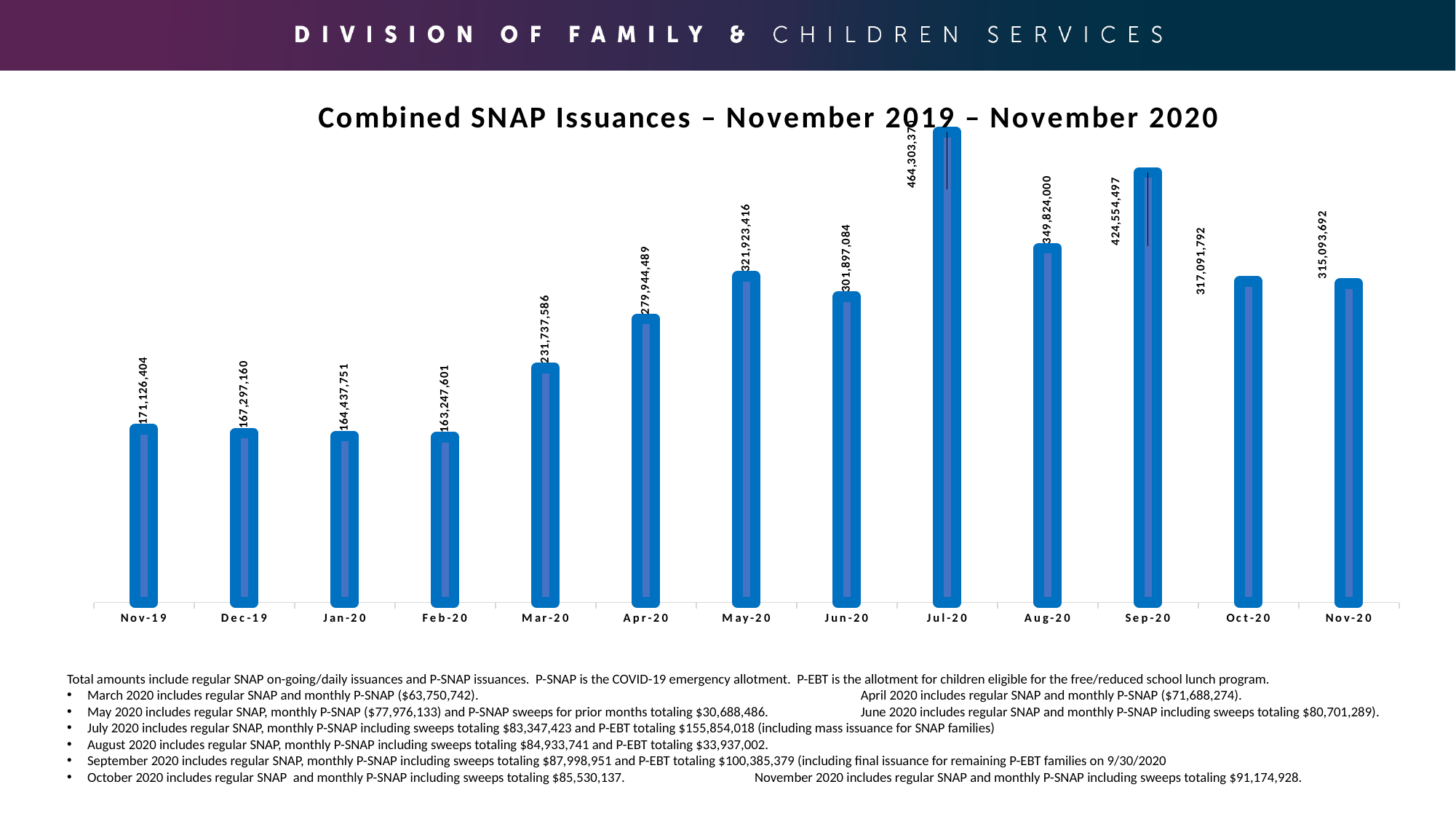
What is the difference between the values for Nov-19 and Dec-19? 3,829,244 What is the value for Oct-20? 317,091,792 What is the value for Sep-20? 424,554,497 What is the difference between the values for Oct-20 and Nov-20? 1,998,100 What is the value for Mar-20? 231,737,586 Which month has the highest combined SNAP issuance? Jul-20 What is the value for Nov-19? 171,126,404 Which month has the lowest combined SNAP issuance? Feb-20 What kind of chart is shown on the slide? Bar chart Do the values rise or fall from Feb-20 to Jul-20? Rise How many months are shown on the chart? 13 Which is larger, the value for May-20 or the value for Jun-20? May-20